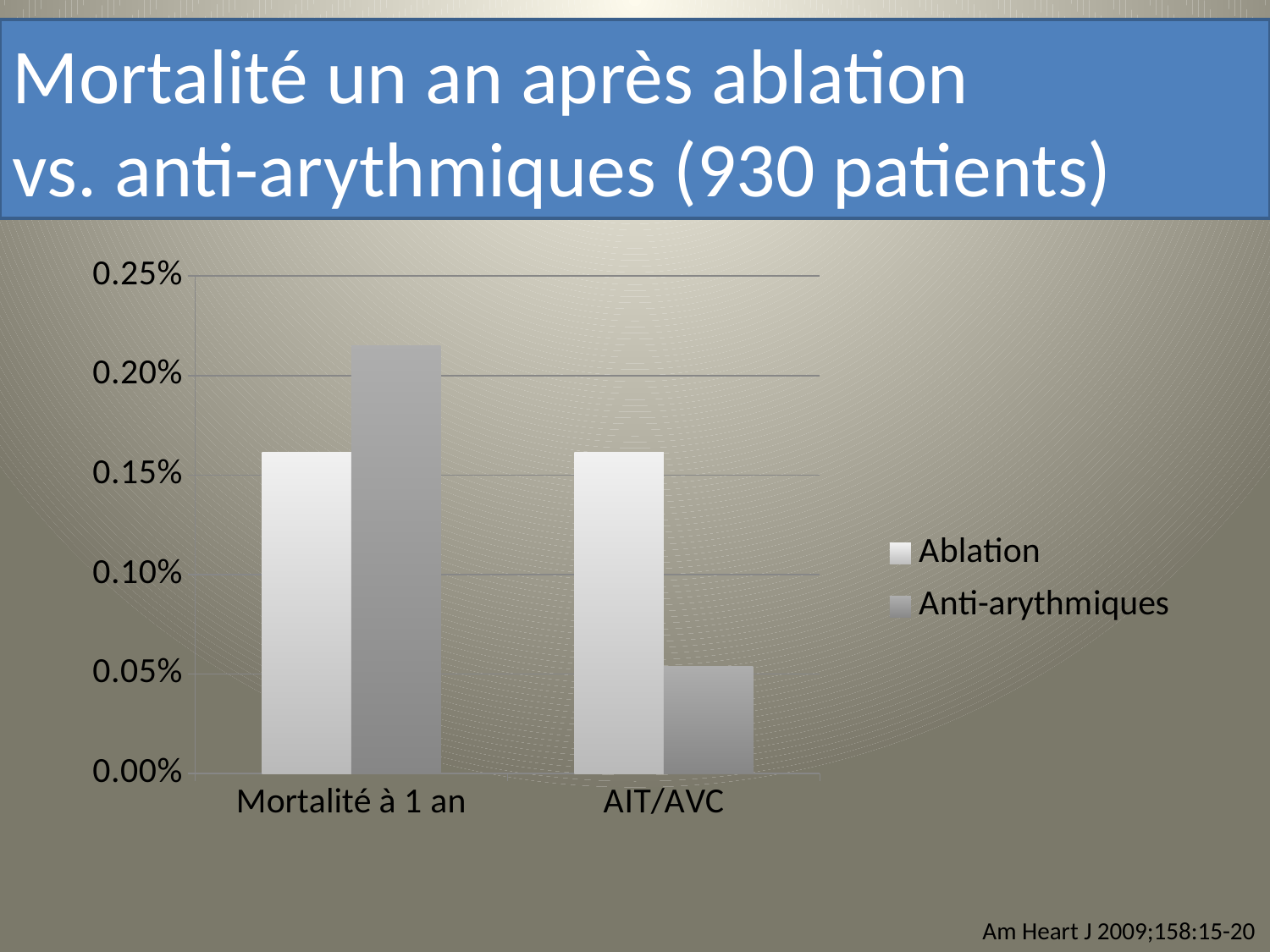
For AIT/AVC, which series has the larger value, Ablation or Anti-arythmiques? Ablation What kind of chart is shown on the slide? bar chart For Mortalité à 1 an, which series has the larger value, Ablation or Anti-arythmiques? Anti-arythmiques Which bar is the lowest in the chart? Anti-arythmiques in AIT/AVC Is the value for Anti-arythmiques in AIT/AVC greater or less than 0.10%? less How many categories are shown on the x axis? 2 Is the value for Ablation in Mortalité à 1 an greater or less than 0.15%? greater Is the value for Anti-arythmiques in Mortalité à 1 an greater or less than 0.20%? greater How many series does the legend list? 2 Which series are listed in the legend? Ablation and Anti-arythmiques What are the two categories on the x axis? Mortalité à 1 an and AIT/AVC